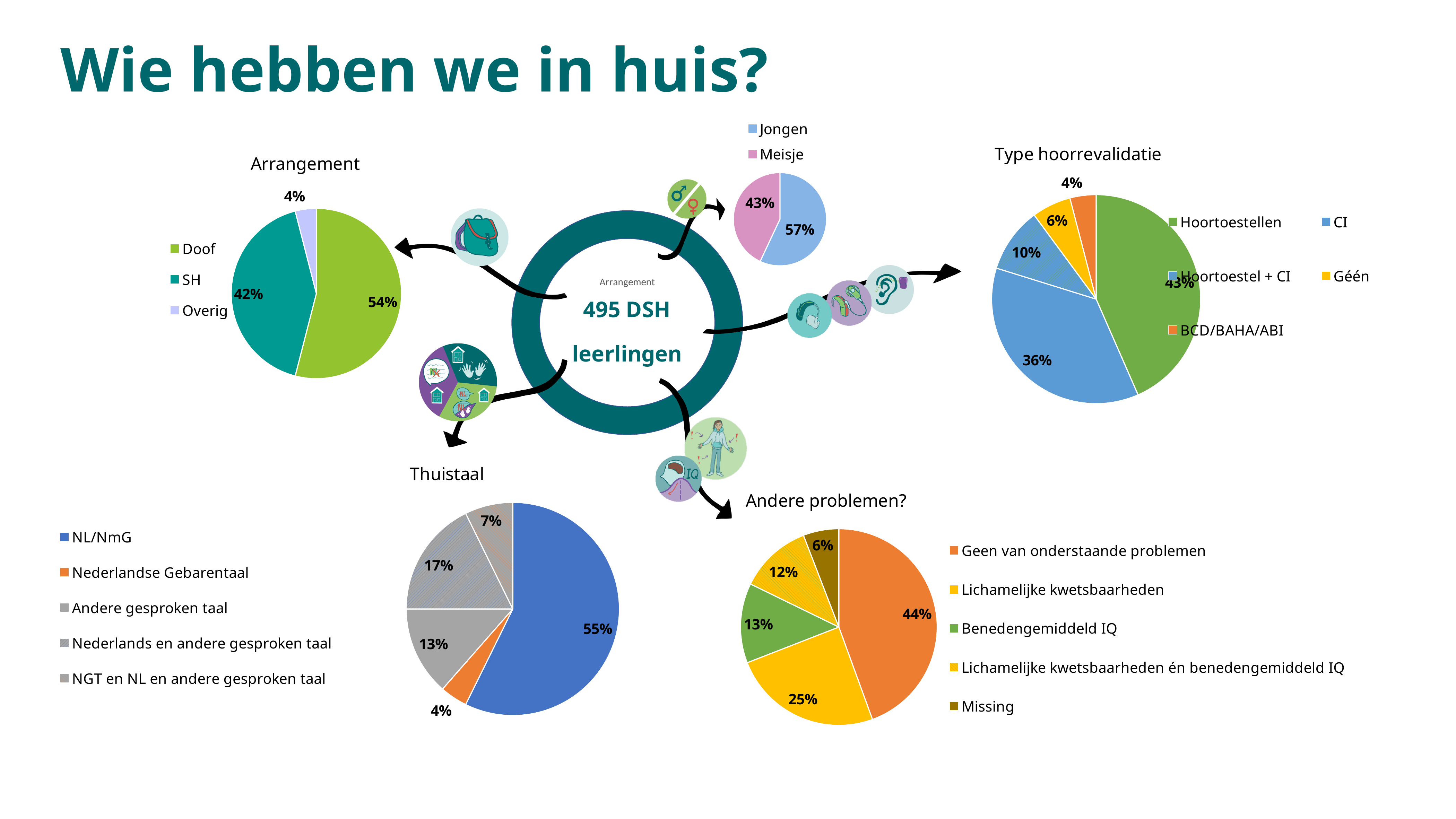
In the Thuistaal pie chart, what percentage is NL/NmG? 55% In the Type hoorrevalidatie pie chart, which category has the largest share? Hoortoestellen In the Andere problemen? pie chart, what percentage is Lichamelijke kwetsbaarheden? 25% What type of chart is used for Andere problemen? Pie chart In the gender pie chart, which is larger, Jongen or Meisje? Jongen In the Arrangement pie chart, which category has the smallest share? Overig In the gender pie chart (Jongen/Meisje), what percentage is Jongen? 57% In the Arrangement pie chart, what is the difference between the Doof and SH shares? 12% In the Type hoorrevalidatie pie chart, what percentage is CI? 36% In the Arrangement pie chart, what percentage is Doof? 54% In the Thuistaal pie chart, what percentage is Nederlandse Gebarentaal? 4% How many categories does the Type hoorrevalidatie pie chart have? 5